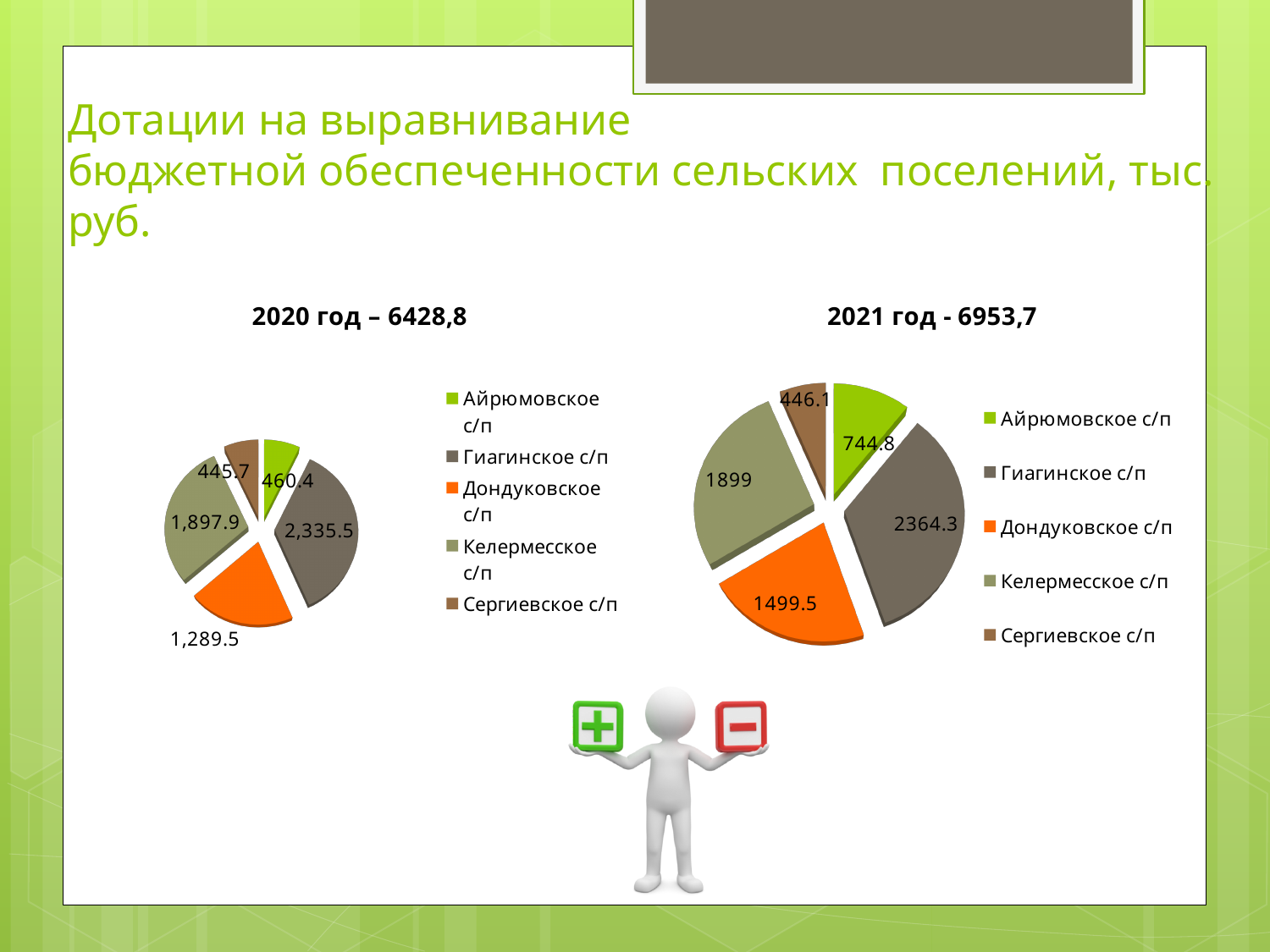
On the 2021 pie chart, which is larger: Айрюмовское с/п or Сергиевское с/п? Айрюмовское с/п On the 2021 pie chart, which settlement has the largest slice? Гиагинское с/п On the 2021 pie chart, what is the value for Дондуковское с/п? 1499.5 What total is shown in the title of the 2021 chart? 6953,7 On the 2020 pie chart, what is the value for Сергиевское с/п? 445.7 On the 2020 pie chart, what is the value for Гиагинское с/п? 2,335.5 On the 2020 pie chart, what is the difference between the values for Келермесское с/п and Дондуковское с/п? 608.4 On the 2021 pie chart, what is the difference between the values for Гиагинское с/п and Дондуковское с/п? 864.8 How many slices does the 2020 pie chart have? 5 What kind of chart is used for the 2021 data? Pie chart On the 2021 pie chart, what is the value for Келермесское с/п? 1899 On the 2020 pie chart, which settlement has the smallest slice? Сергиевское с/п